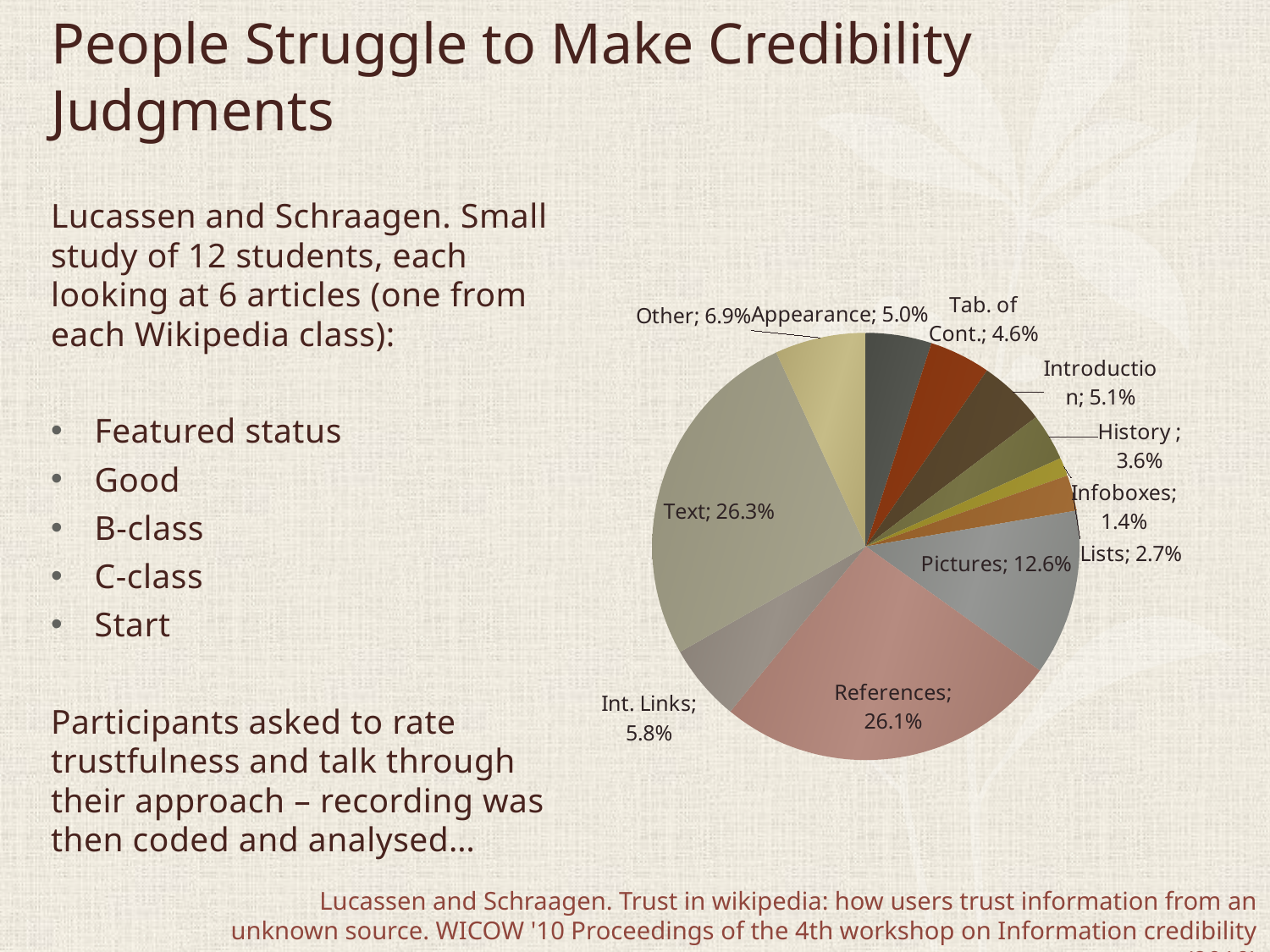
Which is larger, the share for Pictures or the share for Other? Pictures What is the difference in percentage points between Pictures and Int. Links? 6.8 What kind of chart is shown on the slide? Pie chart What is the value shown for Infoboxes? 1.4% What is the value shown for Int. Links? 5.8% What is the value shown for Tab. of Cont.? 4.6% What share of the pie does Pictures account for? 12.6% Which slice has the smallest share of the pie? Infoboxes What is the difference in percentage points between Text and References? 0.2 How many slices does the pie chart have? 11 Which slice has the largest share of the pie? Text What is the value shown for References? 26.1%